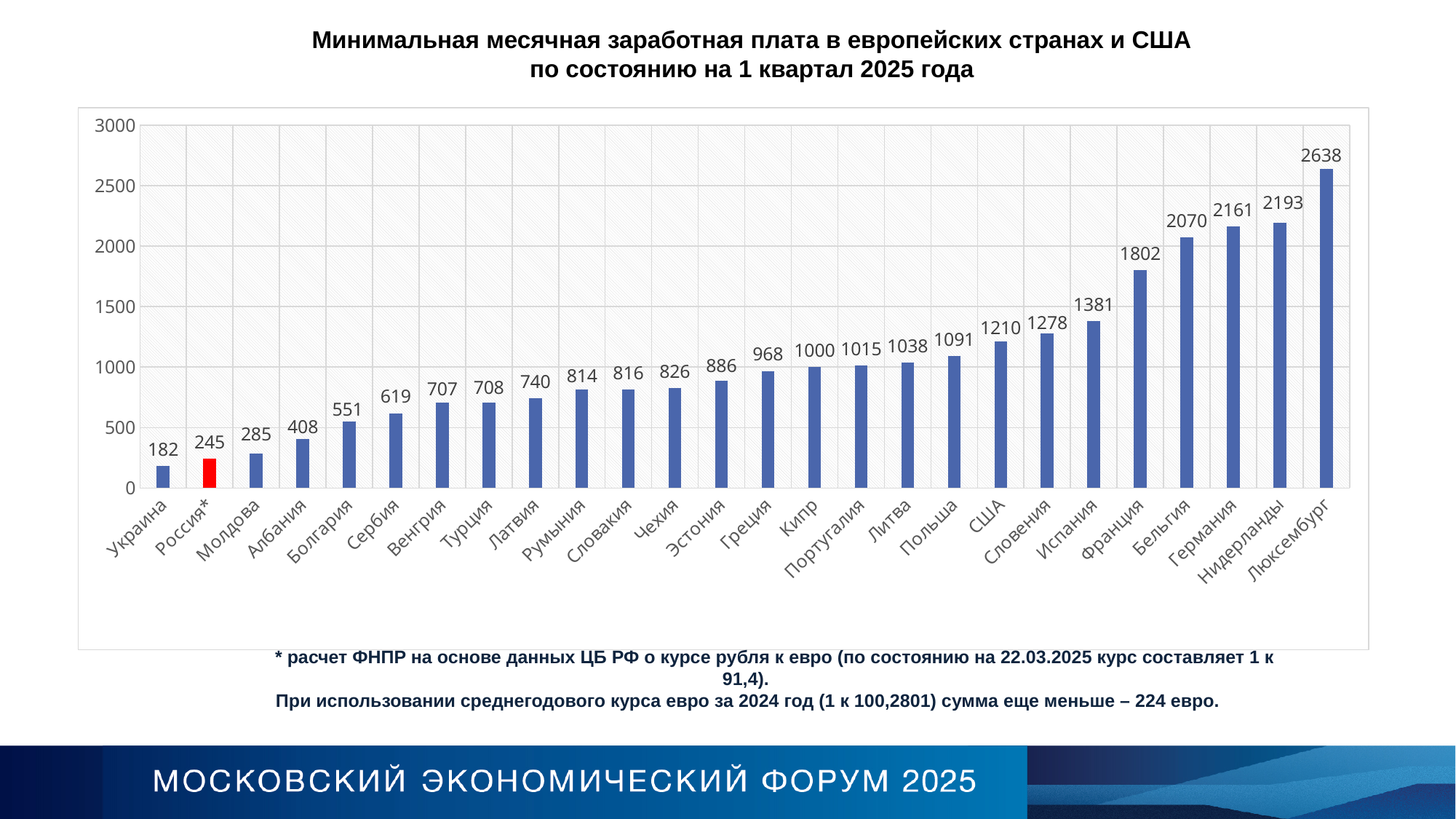
What is the difference between the values for Люксембург and Россия*? 2393 Which country has the lowest value on the chart? Украина What kind of chart is shown on the slide? bar chart Which bar is coloured red instead of blue? Россия* What is the minimum monthly wage shown for Россия*? 245 Which is larger, the value for Польша or the value for Литва? Польша What value is shown for Германия? 2161 How many countries are shown on the chart? 26 Which country has the highest value on the chart? Люксембург What is the difference between the values for Нидерланды and Бельгия? 123 Is the value for Испания greater or less than 1500? less What value is shown for США? 1210